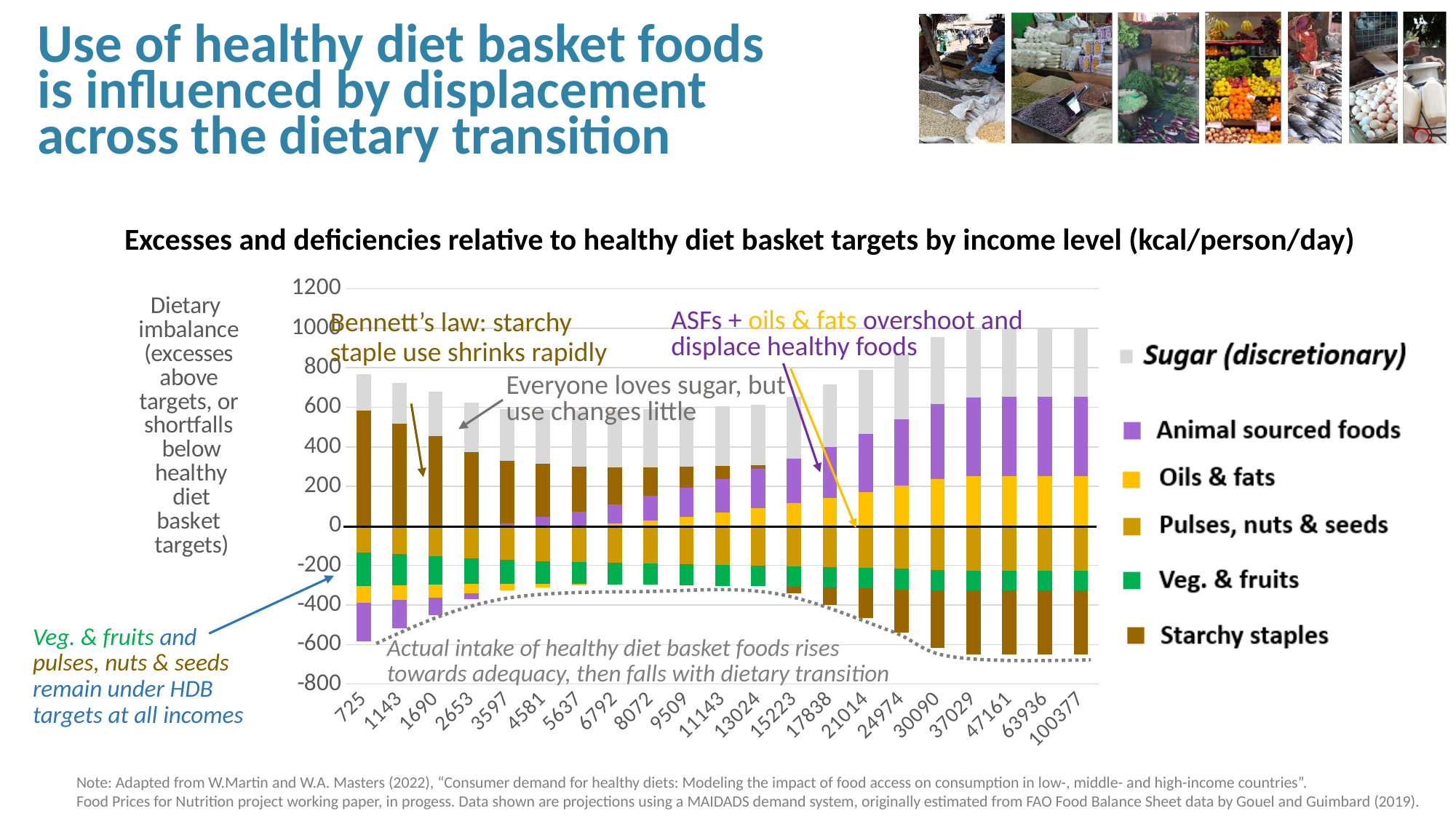
What kind of chart is shown on the slide? Stacked bar chart Is the bottom of the stacked bar below zero for income level 725 greater or less than -400? less Is the top of the stacked bar above zero for income level 725 greater or less than 600? greater Does the Animal sourced foods segment move from below zero to above zero as income rises along the x axis? Yes Does the Starchy staples excess above zero rise or fall as income increases from 725 to 13024? Fall What is the title of the chart? Excesses and deficiencies relative to healthy diet basket targets by income level (kcal/person/day) Is the top of the stacked bar above zero for income level 100377 greater or less than 800? greater Which income level has a taller stack above zero: 725 or 100377? 100377 Which colour represents Animal sourced foods in the chart? Purple What is the first income level shown on the x axis? 725 How many income-level categories are shown along the x axis of the chart? 21 How many series does the chart legend list? 6